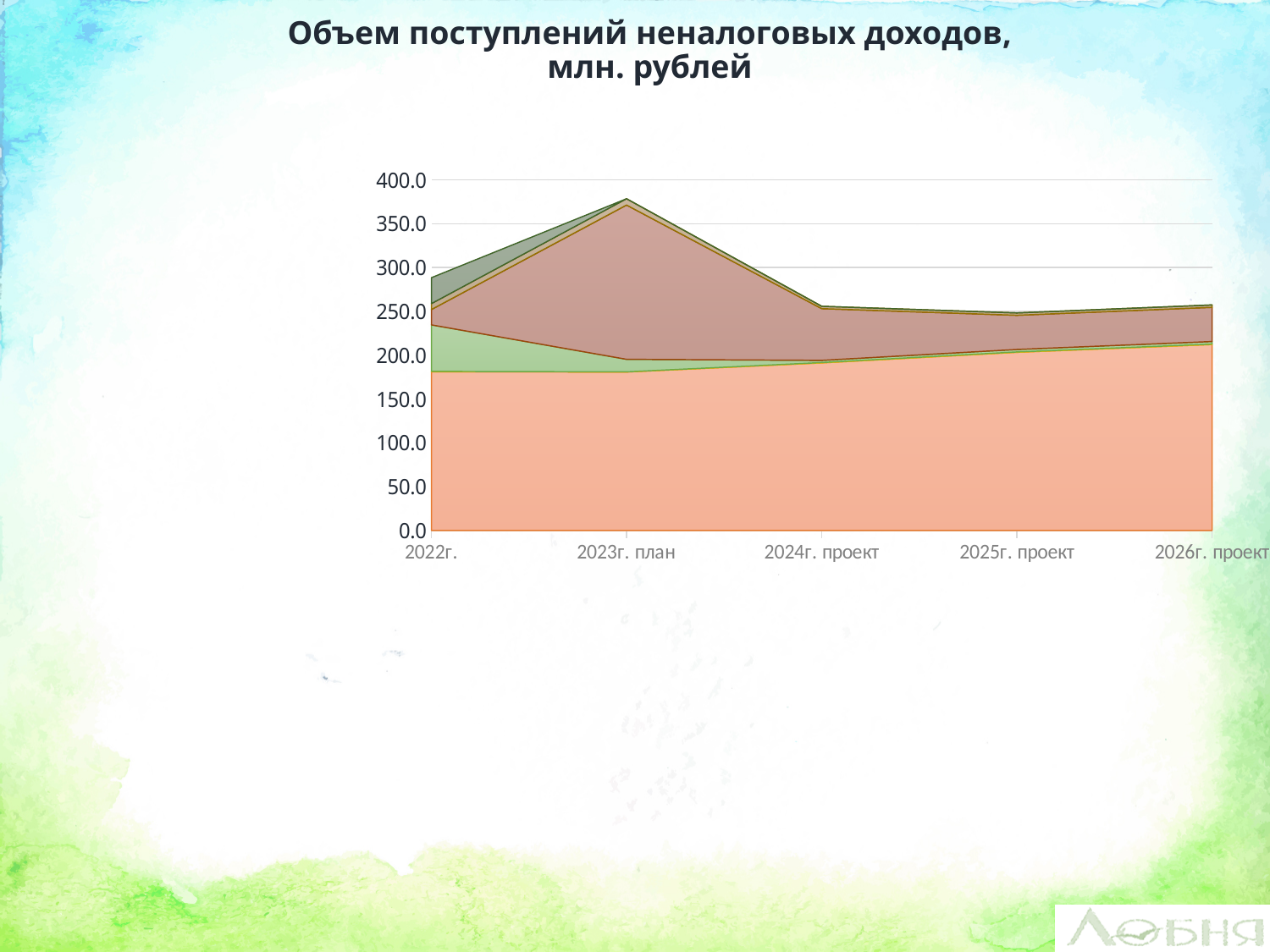
How many categories are shown on the x axis? 5 Which is higher, the top of the plotted area for 2022г. or for 2023г. план? 2023г. план What is the label of the first category on the x axis? 2022г. What kind of chart is shown on the slide? area chart What is the title of the chart? Объем поступлений неналоговых доходов, млн. рублей Is the top of the plotted area for 2023г. план greater or less than 350.0? greater Does the top of the plotted area rise or fall from 2023г. план to 2024г. проект? fall Does the bottom (orange) area rise or fall from 2022г. to 2026г. проект? rise Is the top of the bottom (orange) area for 2026г. проект greater or less than 200.0? greater Is the top of the plotted area for 2022г. greater or less than 300.0? less Which category has the highest top of the plotted area? 2023г. план